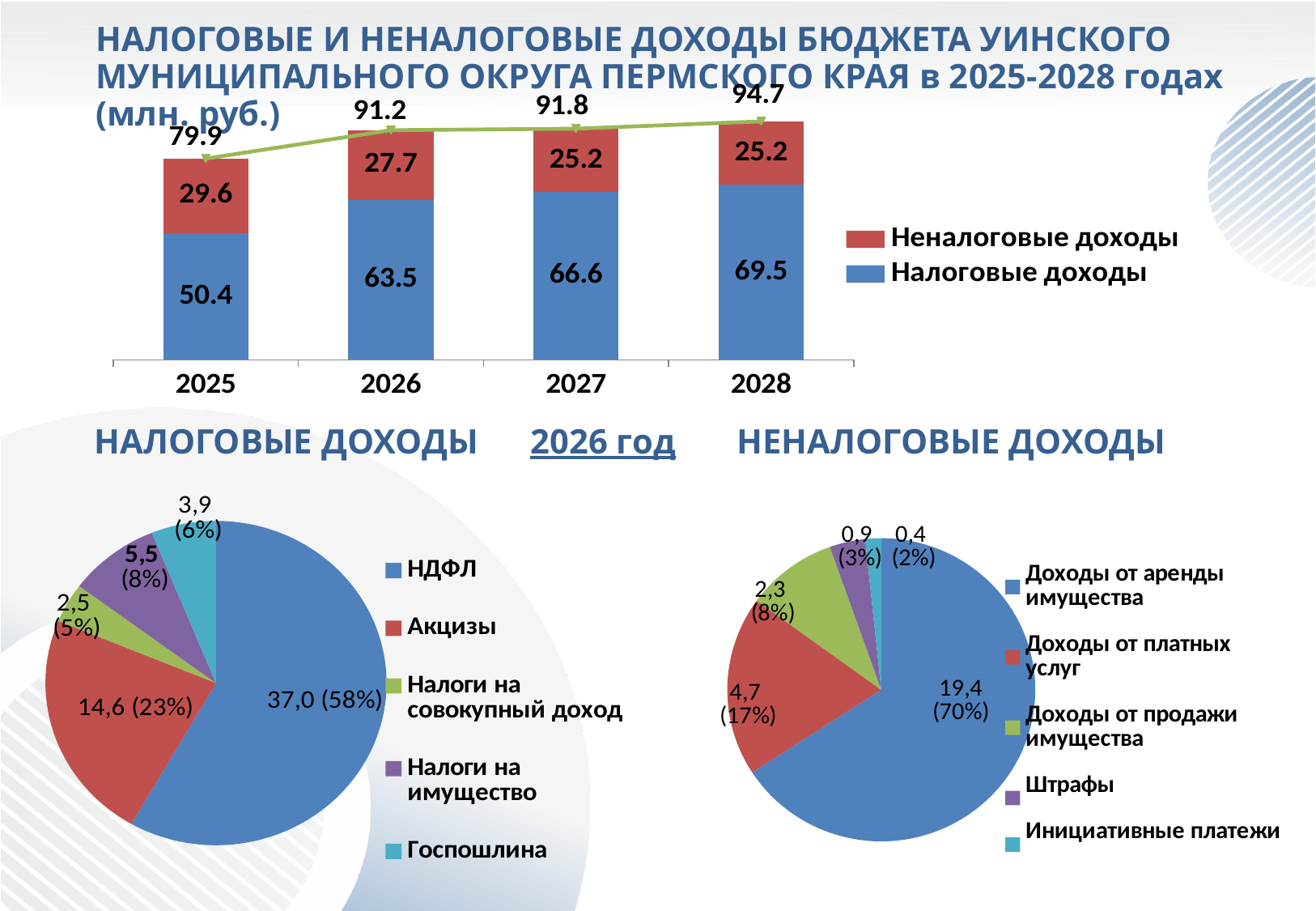
What kind of chart is the НАЛОГОВЫЕ ДОХОДЫ chart at the bottom left? pie chart In the top stacked bar chart, what is the value of Неналоговые доходы for 2025? 29.6 In the top stacked bar chart, do the totals rise or fall from 2025 to 2028? rise In the top stacked bar chart, what is the difference between Налоговые доходы in 2028 and in 2025? 19.1 In the НЕНАЛОГОВЫЕ ДОХОДЫ pie chart, which category is the largest? Доходы от аренды имущества In the НАЛОГОВЫЕ ДОХОДЫ pie chart, what share does НДФЛ have? 58% In the top stacked bar chart, which year has the lowest total? 2025 In the top stacked bar chart, what is the value of Налоговые доходы for 2026? 63.5 How many series does the legend of the top stacked bar chart list? 2 How many categories does the НЕНАЛОГОВЫЕ ДОХОДЫ pie chart have? 5 In the top stacked bar chart, what is the total shown above the bar for 2028? 94.7 In the НАЛОГОВЫЕ ДОХОДЫ pie chart, what is the value for Акцизы? 14,6